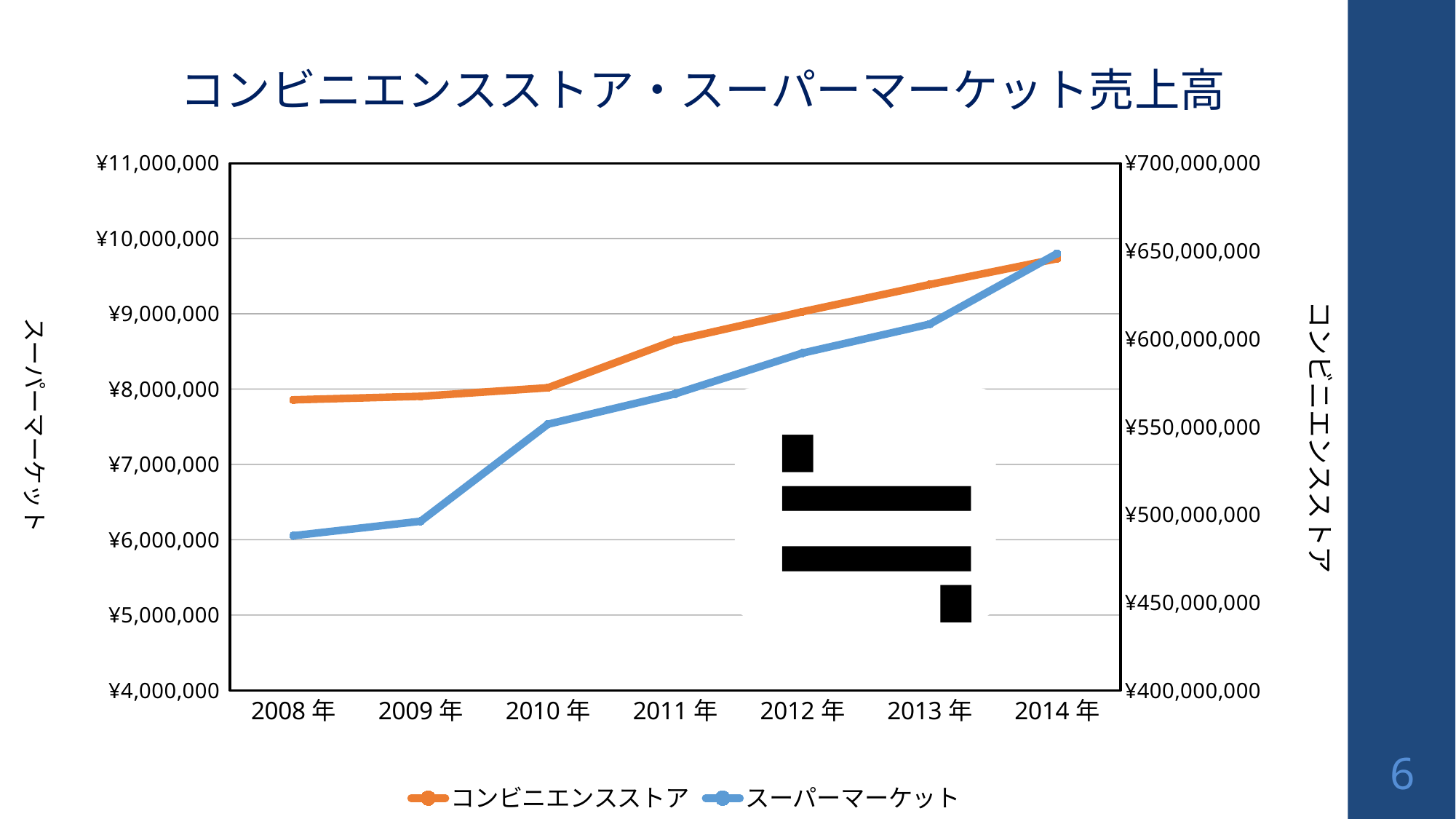
In which year is the スーパーマーケット value highest? 2014年 What is the title of the chart? コンビニエンスストア・スーパーマーケット売上高 In which year is the コンビニエンスストア value lowest? 2008年 Which colour is the スーパーマーケット line? blue Does the コンビニエンスストア line rise or fall from 2008年 to 2014年? rise How many years are plotted along the x axis? 7 What kind of chart is shown on the slide? line chart Does the スーパーマーケット line rise or fall from 2008年 to 2014年? rise Which year has the larger スーパーマーケット value, 2009年 or 2010年? 2010年 How many series does the legend list? 2 On the left axis, is the スーパーマーケット value for 2010年 greater or less than ¥7,000,000? greater